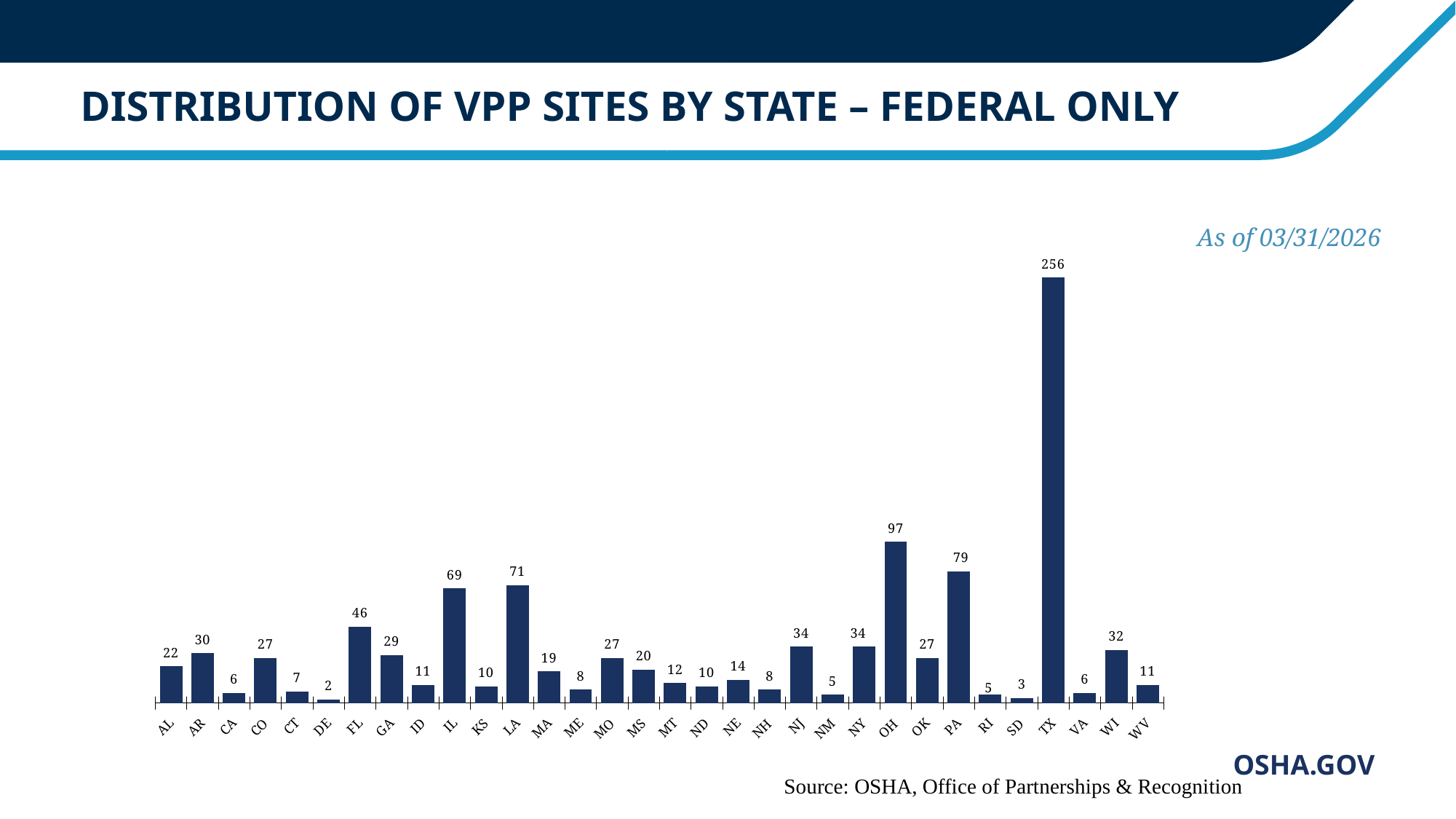
What date is the data current as of, according to the slide? 03/31/2026 What is the value shown for FL? 46 How many states are shown on the x axis? 32 Which has a larger value, AR or WI? WI How many VPP sites does Texas (TX) have? 256 What is the difference between the values for LA and IL? 2 What kind of chart is shown on the slide? Bar chart What is the difference between the values for TX and OH? 159 Which state has the lowest number of VPP sites? DE Which has a larger value, PA or OH? OH Which state has the highest number of VPP sites? TX What is the value shown for OH? 97